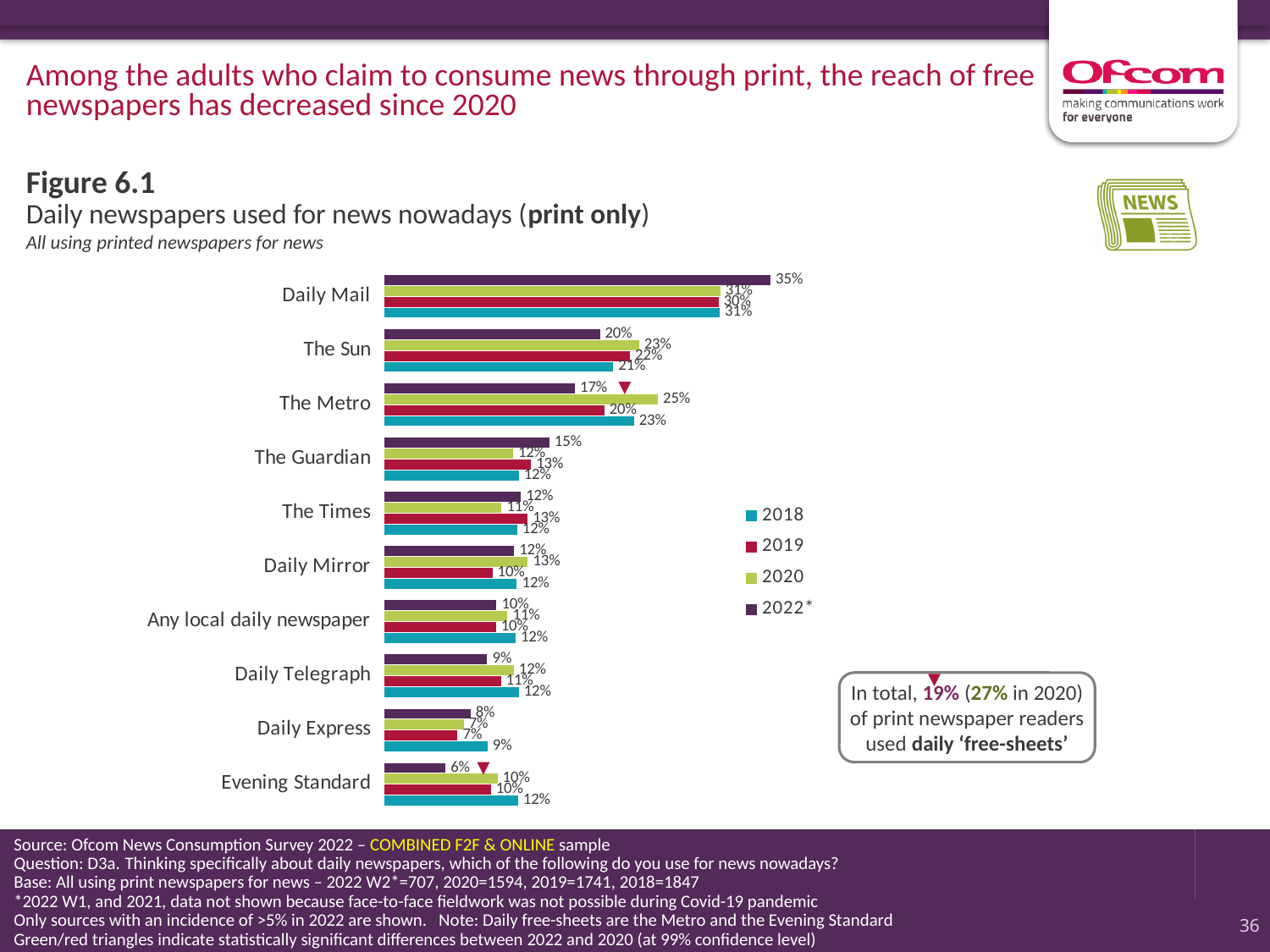
Which newspaper has the highest 2022* value? Daily Mail What type of chart is shown on the slide? Bar chart What is the 2018 value for the Evening Standard? 12% What is the 2019 value for The Sun? 22% For the Daily Telegraph, which is larger: the 2018 value or the 2022* value? 2018 What is the difference between the 2020 and 2022* values for The Metro? 8 percentage points How many series does the legend list? 4 What is the 2022* value for the Daily Mail? 35% What is the 2020 value for The Metro? 25% How many newspaper categories are shown in the chart? 10 Which year does the purple series in the legend represent? 2022* Which newspaper has the lowest 2022* value? Evening Standard